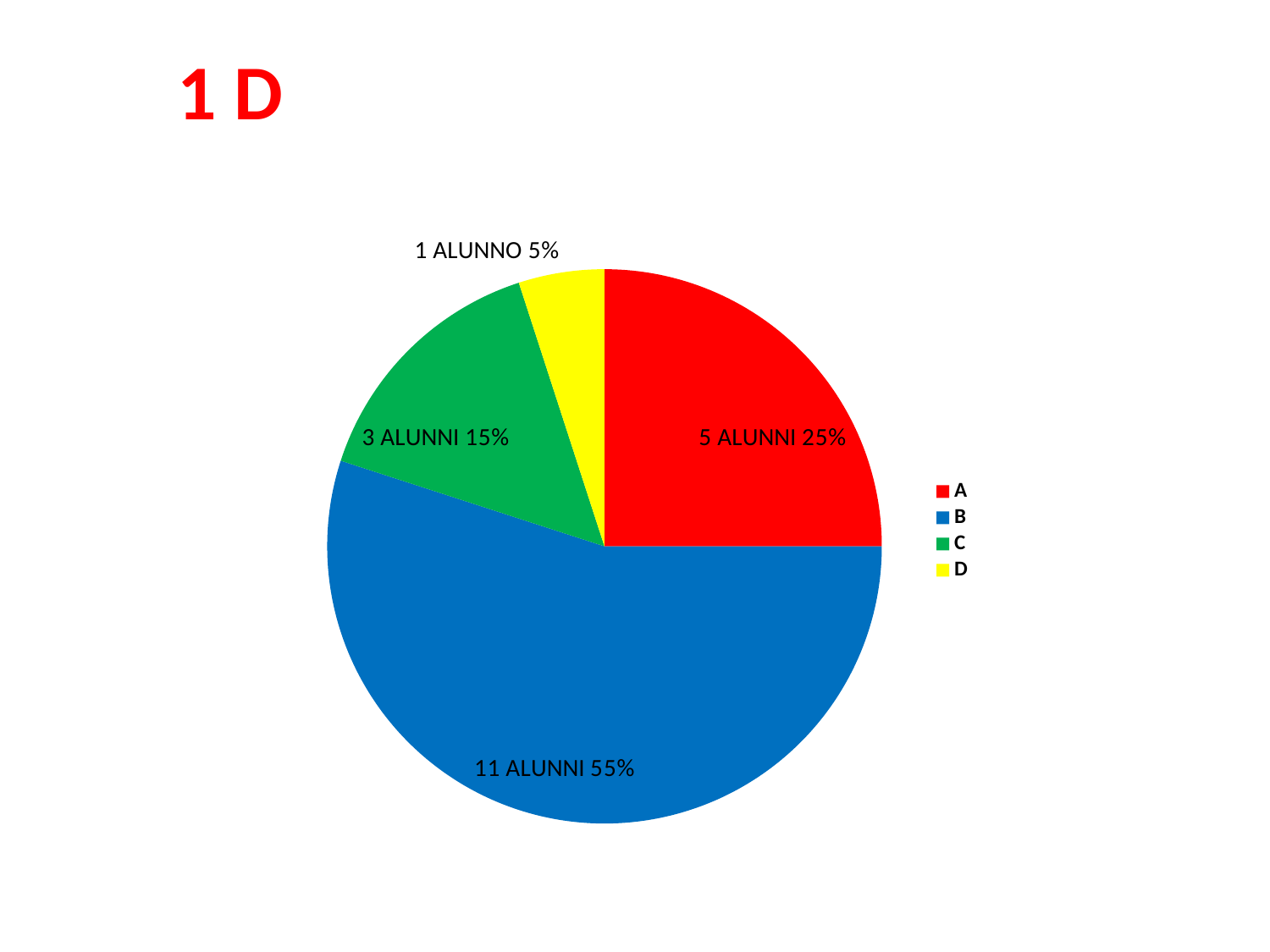
How many more students (alunni) are in category B than in category A? 6 Which category has more students, A or C? A What kind of chart is shown on the slide? pie chart What is the total number of students across all four slices? 20 How many slices does the pie chart have? 4 What percentage share does category C have in the pie chart? 15% What is the data label on the slice for category D? 1 ALUNNO 5% What is the data label on the slice for category B? 11 ALUNNI 55% What colour is the slice for category C? green What percentage share does category A have in the pie chart? 25% Which category has the largest slice of the pie? B Which category has the smallest slice of the pie? D